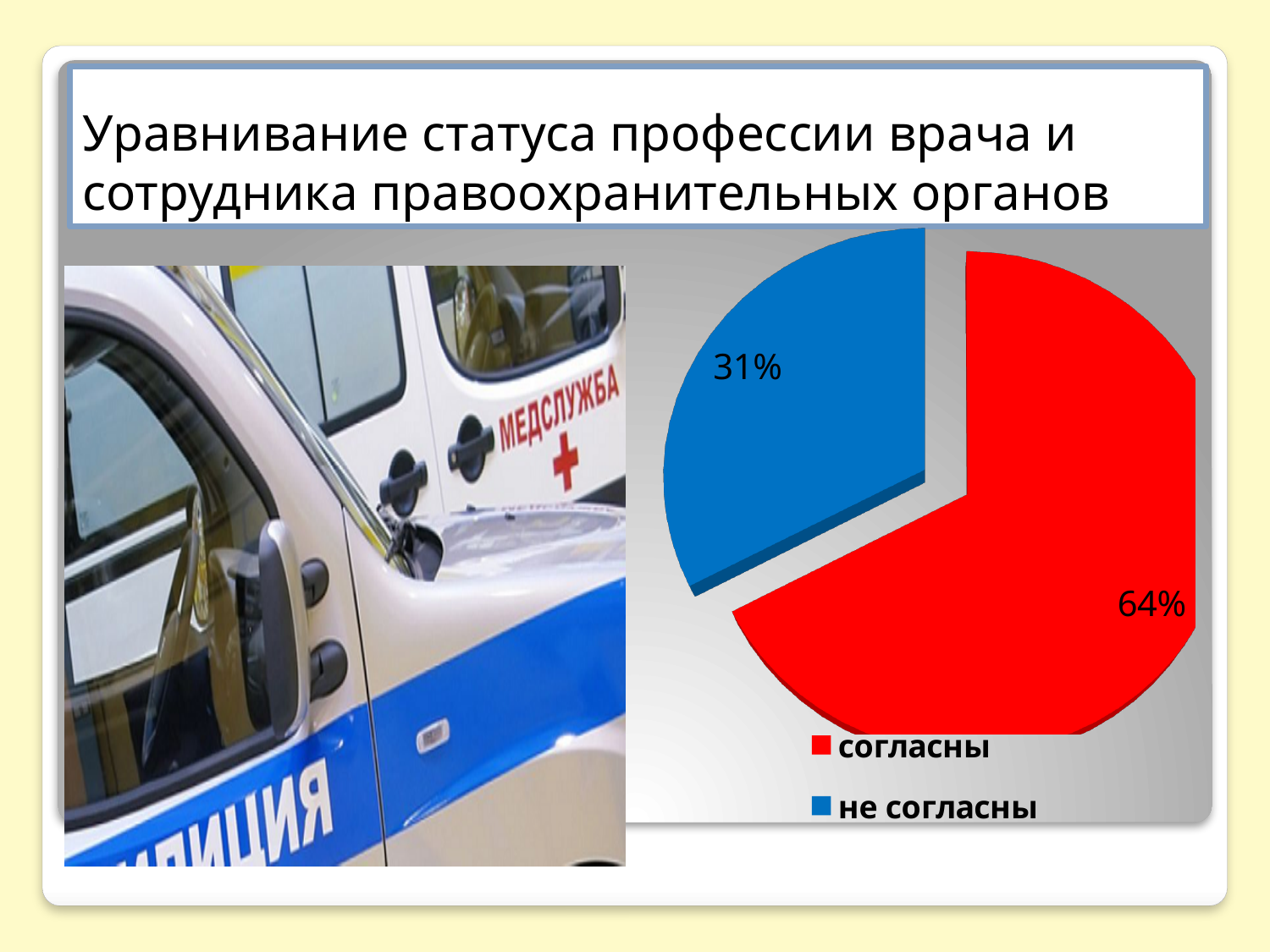
What kind of chart is shown on the slide? Pie chart Which is larger in the pie chart: "согласны" or "не согласны"? согласны Which category has the largest slice in the pie chart? согласны What share of the pie does the "согласны" slice represent? 64% How many entries does the legend of the pie chart list? 2 Which category has the smallest slice in the pie chart? не согласны What percentage of respondents are shown as "не согласны" in the pie chart? 31% What colour is the "согласны" slice in the pie chart? Red By how many percentage points does "согласны" exceed "не согласны" in the pie chart? 33 percentage points What colour is the "не согласны" slice in the pie chart? Blue How many slices does the pie chart have? 2 What percentage of respondents are shown as "согласны" in the pie chart? 64%